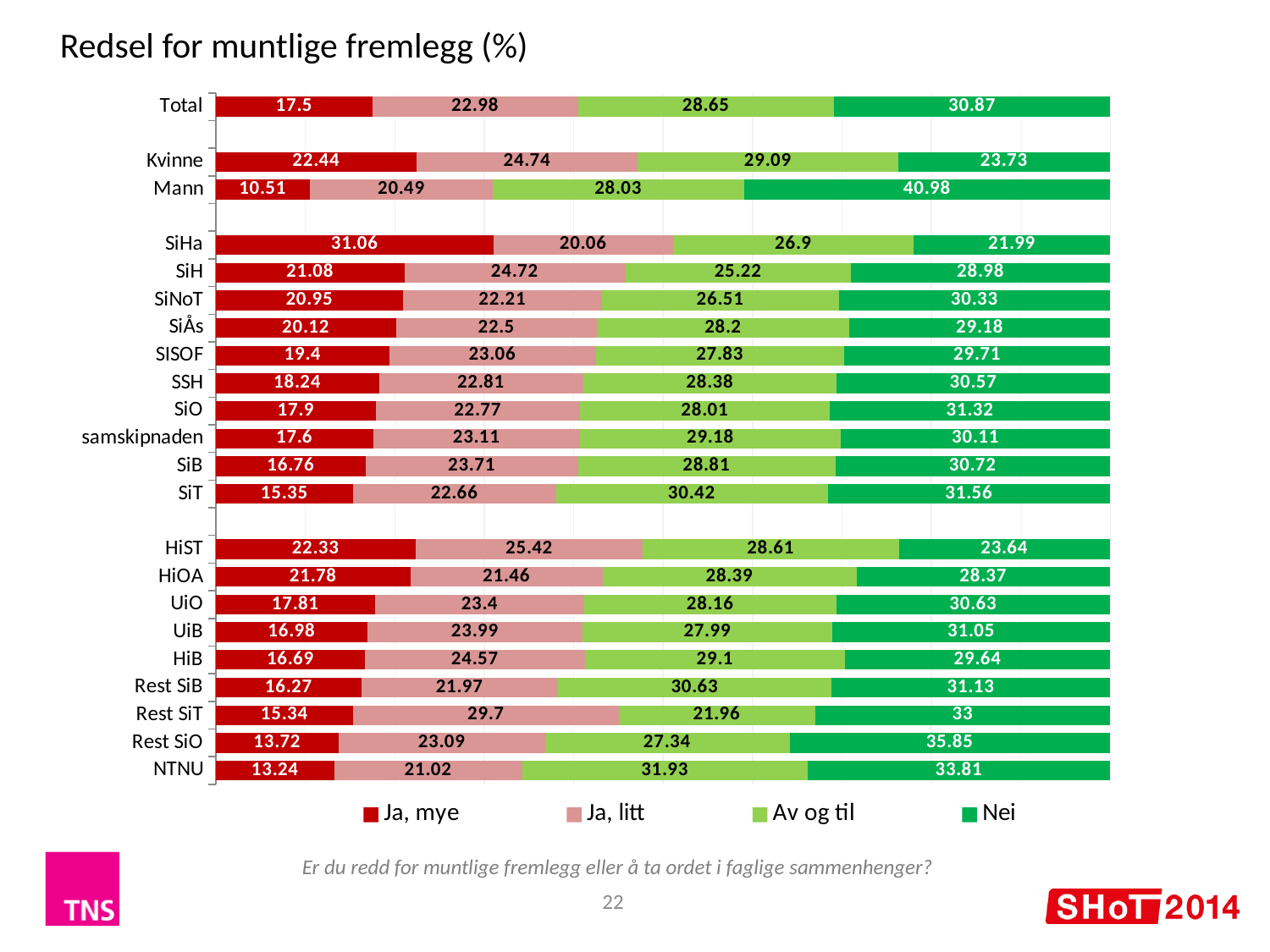
How many categories are plotted on the chart? 22 How many series does the legend list? 4 What is the value of "Ja, litt" for Rest SiT? 29.7 Which category has the lowest value for "Ja, mye"? Mann What is the difference between the "Ja, mye" values for Kvinne and Mann? 11.93 What is the total of the stacked bar for Total? 100 What is the value of "Ja, mye" for Mann? 10.51 Which has a larger "Nei" value, Rest SiO or Rest SiT? Rest SiO What is the value of "Nei" for NTNU? 33.81 Which category has the highest value for "Nei"? Mann What kind of chart is shown on the slide? Stacked bar chart Which category has the highest value for "Ja, mye"? SiHa